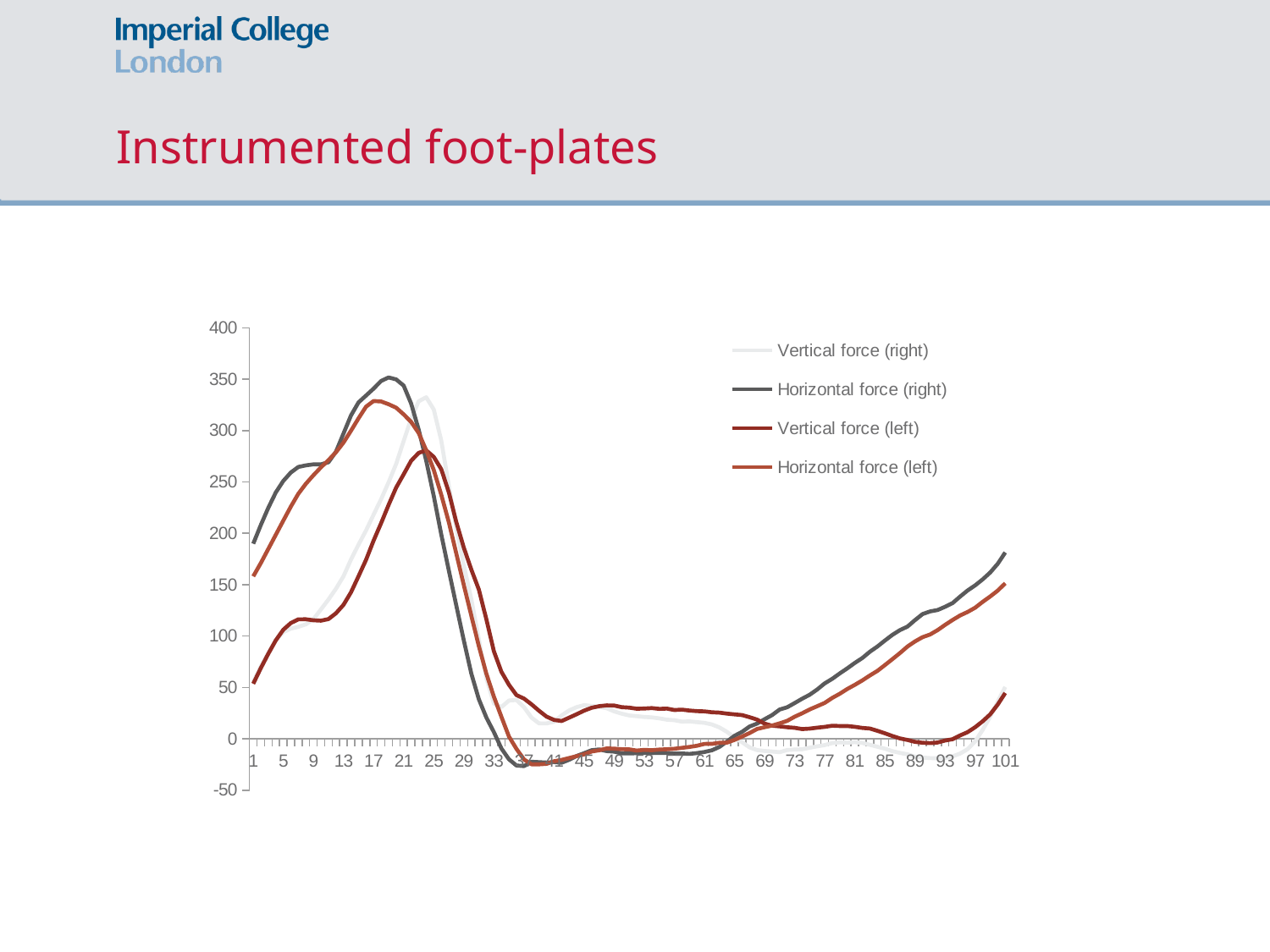
Does the Horizontal force (right) line rise or fall between x = 65 and x = 101? rise What is the highest value shown on the vertical axis? 400 Is the value for Horizontal force (right) at x = 101 greater or less than 150? greater What are the four series named in the legend? Vertical force (right), Horizontal force (right), Vertical force (left), Horizontal force (left) At x = 101, which is higher: Horizontal force (right) or Horizontal force (left)? Horizontal force (right) Is the value for Vertical force (left) at x = 101 greater or less than 100? less How many series does the legend list? 4 Is the value for Vertical force (left) at x = 1 greater or less than 100? less At x = 1, which is higher: Horizontal force (right) or Vertical force (left)? Horizontal force (right) What kind of chart is shown on the slide? line chart